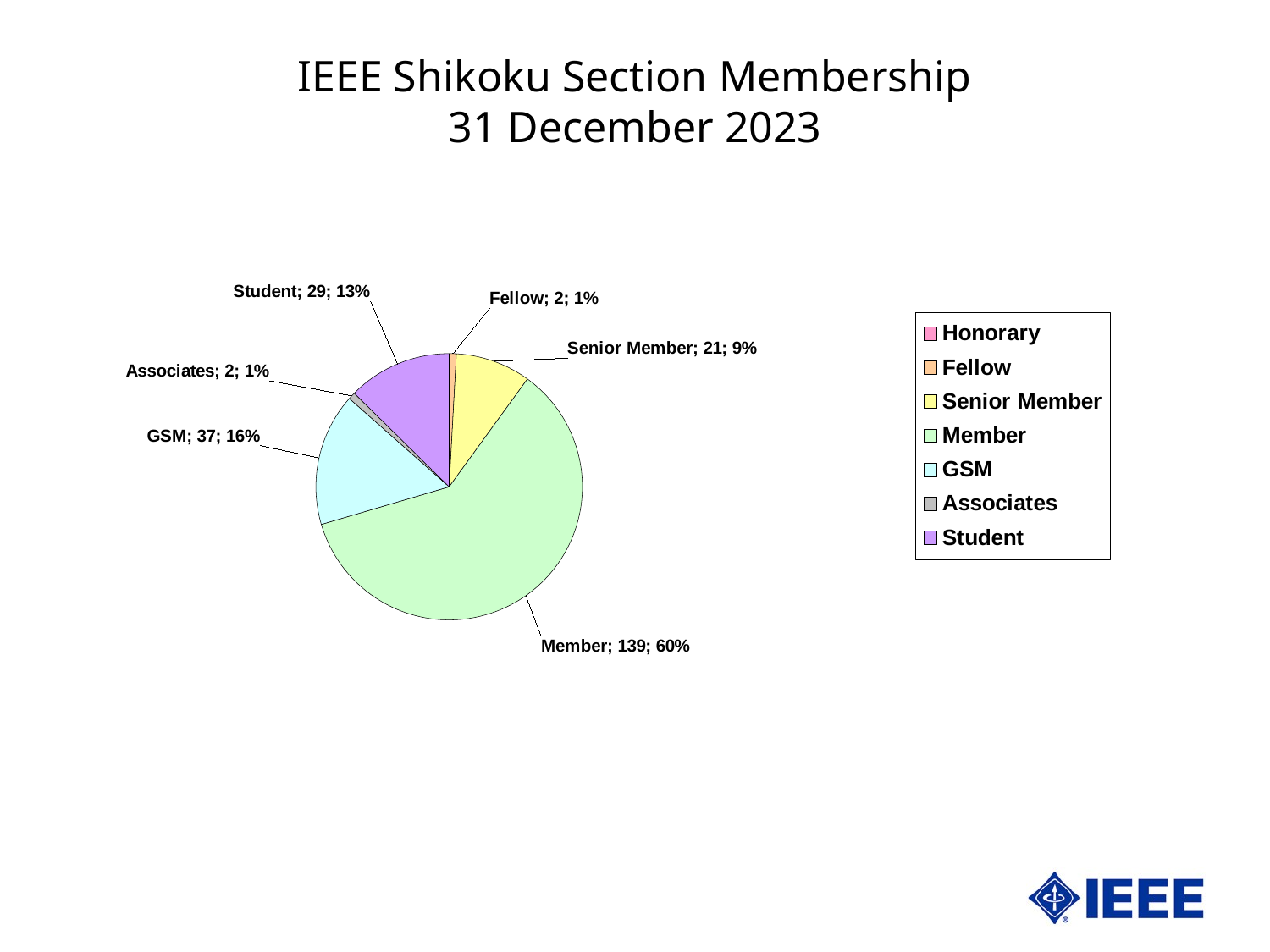
What is the difference between the Member count and the GSM count? 102 How many members are in the Member category? 139 What kind of chart is shown on the slide? pie chart What percentage share does the GSM slice have? 16% How many members are in the Fellow category? 2 What percentage share does the Senior Member slice have? 9% What is the difference between the GSM count and the Student count? 8 Which is larger, the Student count or the Senior Member count? Student How many entries does the legend list? 7 Which category has the largest slice of the pie? Member How many members are in the Student category? 29 What is the title of the slide containing the chart? IEEE Shikoku Section Membership 31 December 2023